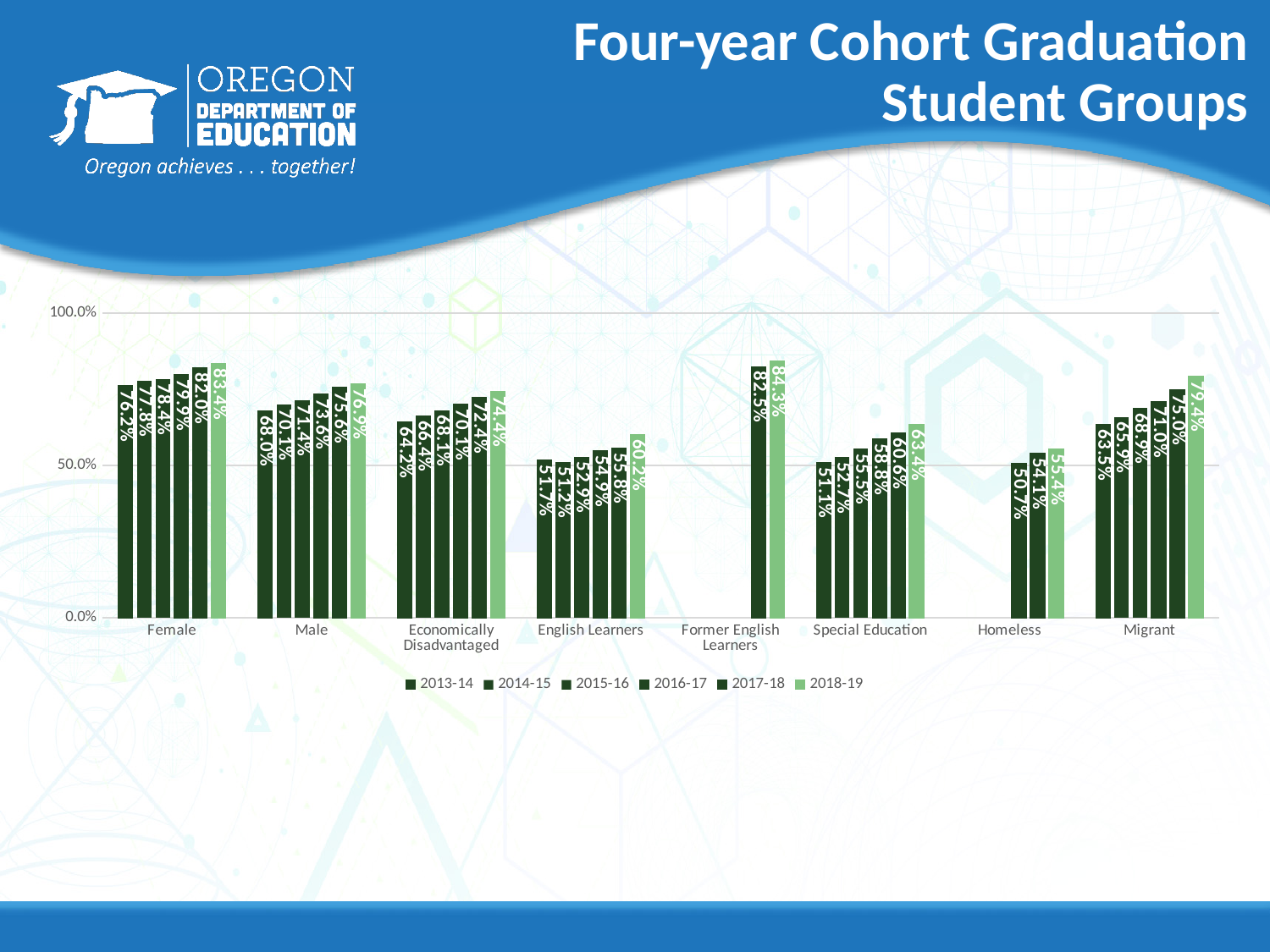
What is the 2018-19 graduation rate for Migrant students? 79.4% What is the difference between the 2018-19 and 2013-14 graduation rates for Male students? 8.9% What is the 2018-19 four-year cohort graduation rate for Female students? 83.4% How many series does the legend list? 6 Which series is shown in the lightest green in the legend? 2018-19 Which student group has the highest 2018-19 graduation rate? Former English Learners How many student groups are shown on the x axis? 8 What is the 2013-14 graduation rate for Economically Disadvantaged students? 64.2% Which is larger, the 2018-19 graduation rate for Special Education students or for English Learners? Special Education Do the graduation rates for Migrant students rise or fall from 2013-14 to 2018-19? Rise Which student group has the lowest 2018-19 graduation rate? Homeless What kind of chart is shown on the slide? Bar chart